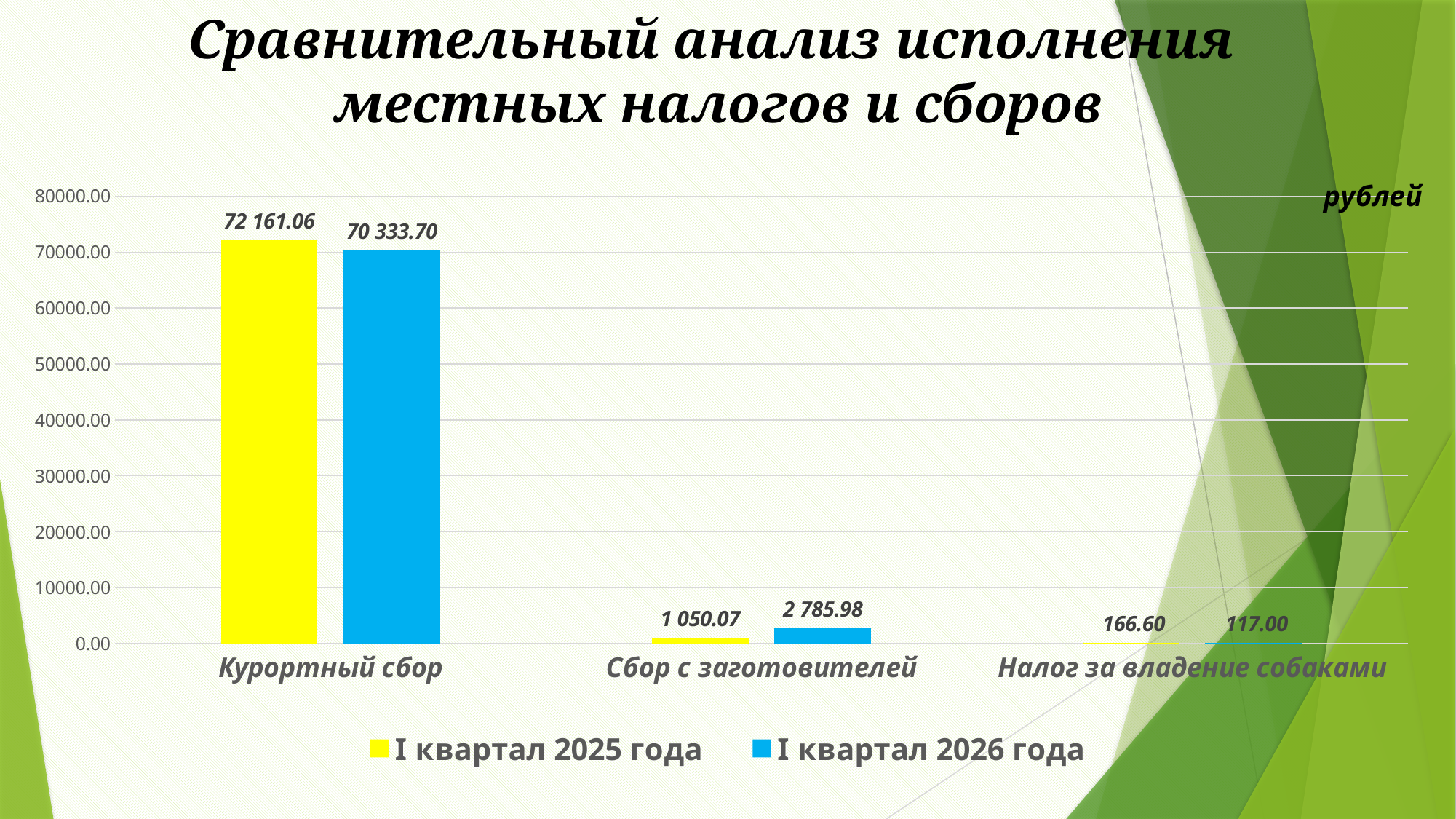
For Сбор с заготовителей, which series has the larger value: I квартал 2025 года or I квартал 2026 года? I квартал 2026 года What is the value for Курортный сбор in the I квартал 2026 года series? 70 333.70 What kind of chart is shown on the slide? Bar chart How many series does the legend list? 2 What is the value for Сбор с заготовителей in the I квартал 2026 года series? 2 785.98 What is the value for Налог за владение собаками in the I квартал 2025 года series? 166.60 What is the difference between the I квартал 2026 года and I квартал 2025 года values for Сбор с заготовителей? 1 735.91 What is the value for Курортный сбор in the I квартал 2025 года series? 72 161.06 How many categories are shown on the x axis? 3 Which category has the highest value in the I квартал 2026 года series? Курортный сбор What is the difference between the I квартал 2025 года and I квартал 2026 года values for Курортный сбор? 1 827.36 Which category has the lowest value in the I квартал 2025 года series? Налог за владение собаками